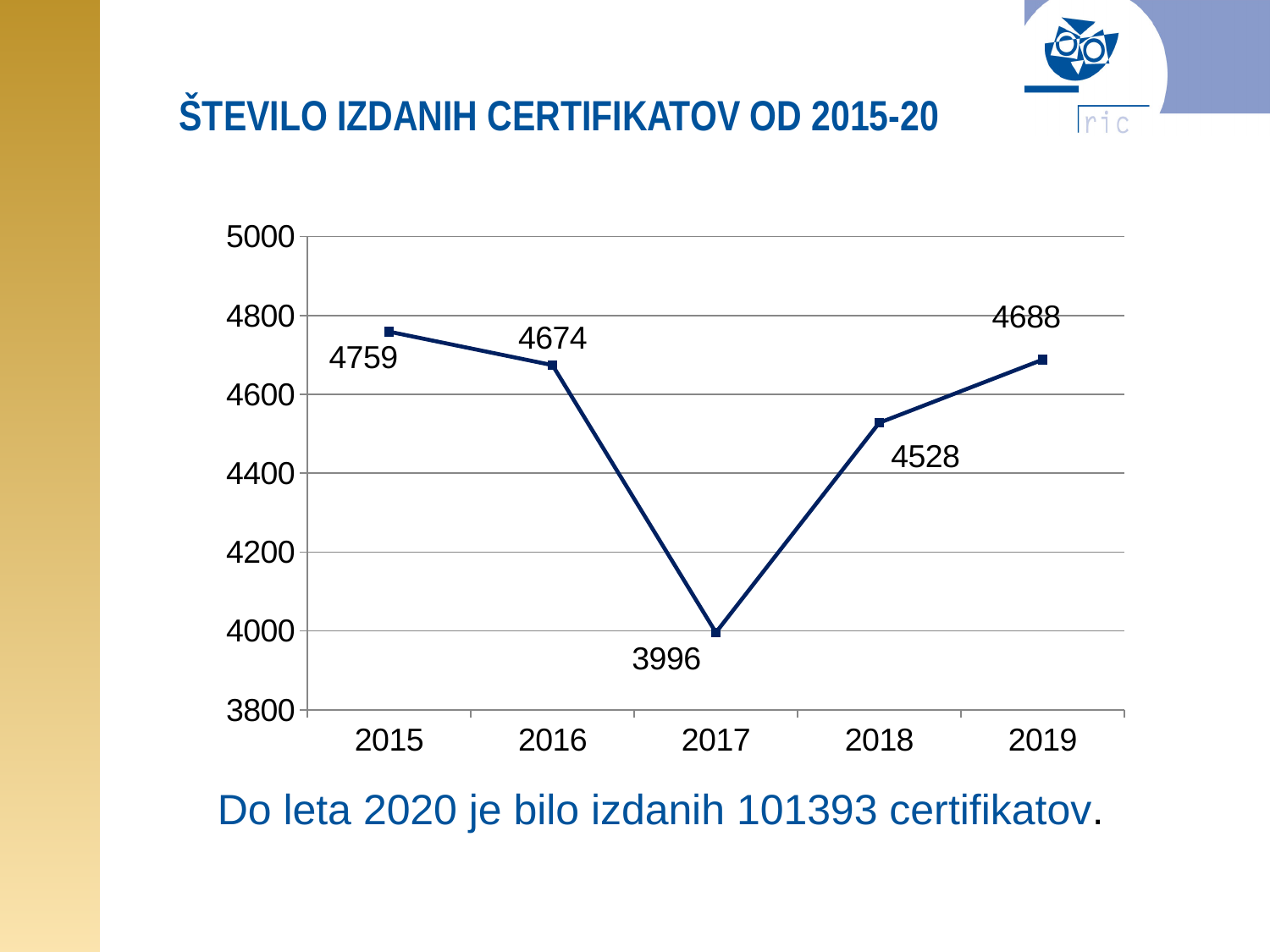
How many years are plotted on the chart? 5 What kind of chart is shown on the slide? line chart Is the value for 2018 greater or less than 4600? less Do the values rise or fall from 2017 to 2019? rise What is the difference between the values for 2019 and 2018? 160 Which year has the highest value? 2015 Which is larger, the value for 2016 or the value for 2018? 2016 Which year has the lowest value? 2017 What is the difference between the values for 2016 and 2017? 678 What is the value for 2015? 4759 What is the value for 2019? 4688 What is the value for 2017? 3996